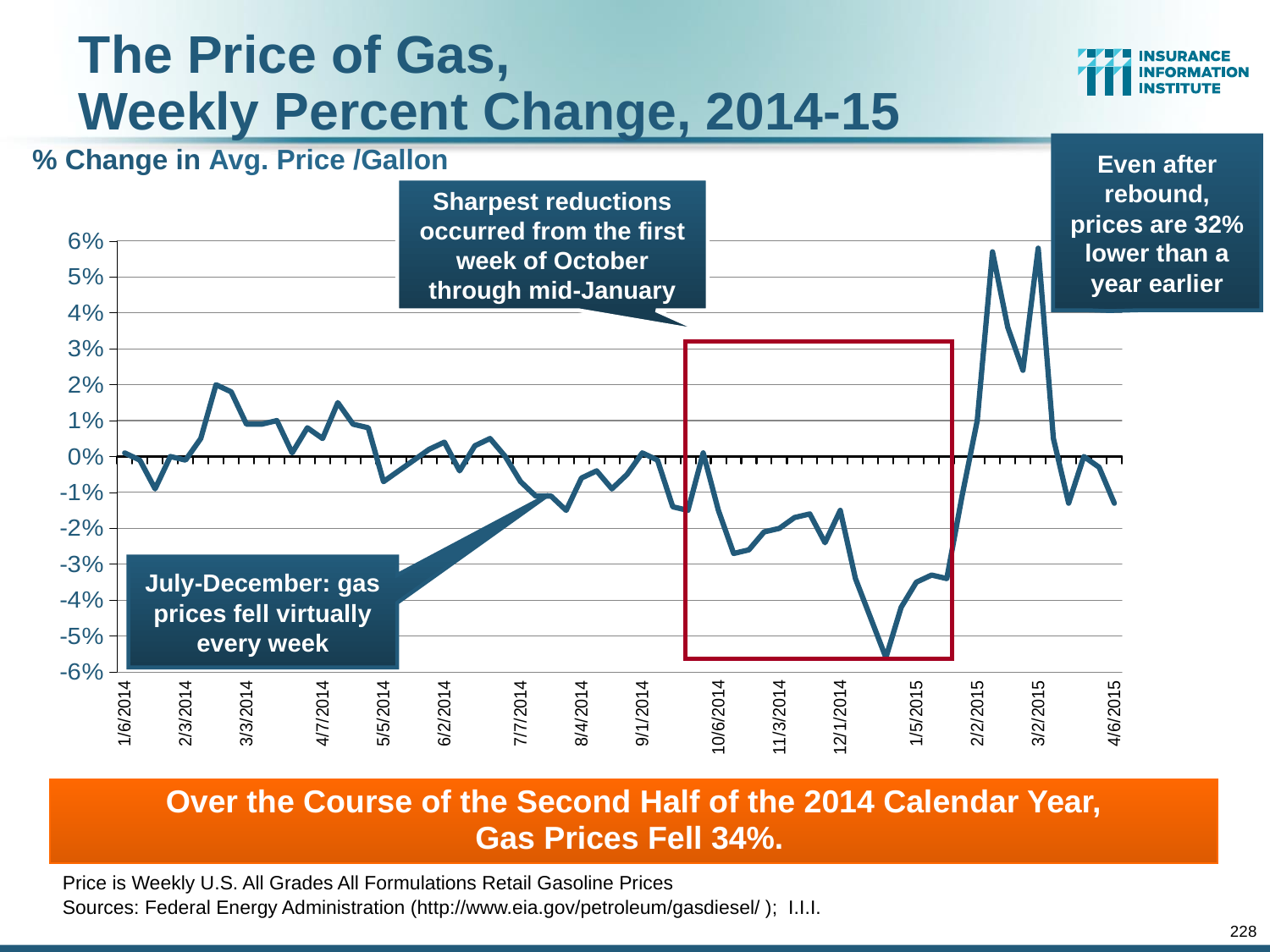
What is the title of the chart? The Price of Gas, Weekly Percent Change, 2014-15 Is the value for 7/7/2014 greater or less than 0%? less Between 1/5/2015 and 2/2/2015, does the line rise or fall? rise Is the value for 4/6/2015 greater or less than 0%? less What is the highest value shown on the y axis? 6% What label is shown above the chart describing the plotted values? % Change in Avg. Price /Gallon What kind of chart is shown on the slide? line chart Is the value for 3/3/2014 greater or less than 0%? greater How many date labels are shown along the x axis? 16